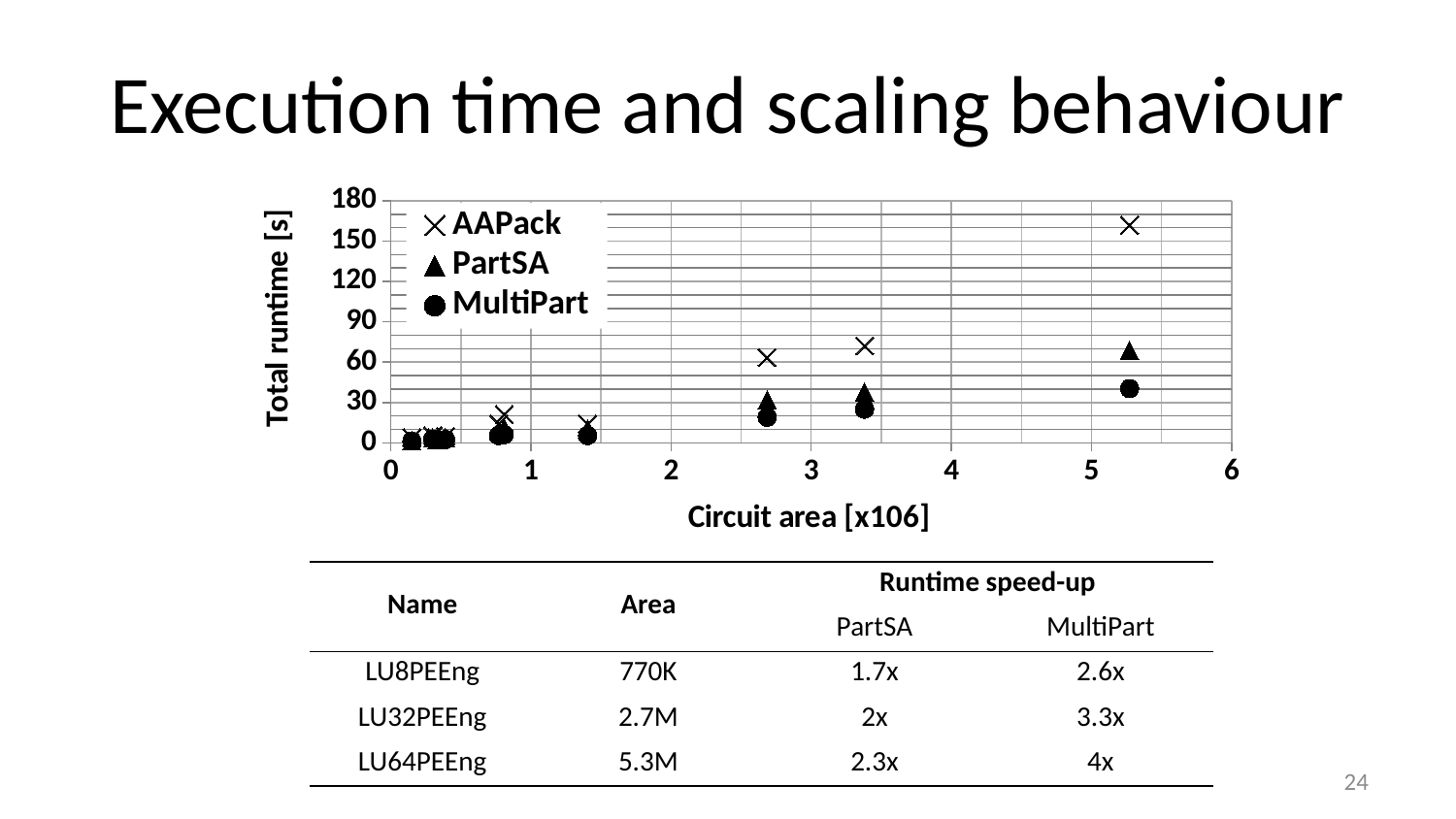
What kind of chart is shown on the slide? scatter chart Is the PartSA runtime at the largest circuit area (around 5.3) greater or less than 60? greater Is the MultiPart runtime at the largest circuit area (around 5.3) greater or less than 60? less How many series does the chart legend list? 3 Does the AAPack total runtime rise or fall as circuit area increases? rise Is the AAPack runtime at the largest circuit area (around 5.3) greater or less than 150? greater At the largest circuit area, which series has the higher total runtime, AAPack or MultiPart? AAPack Which series has the lowest total runtime at the largest circuit area? MultiPart What are the three series named in the chart legend? AAPack, PartSA, MultiPart Which series has the highest total runtime at the largest circuit area? AAPack What is the label of the chart's y axis? Total runtime [s]